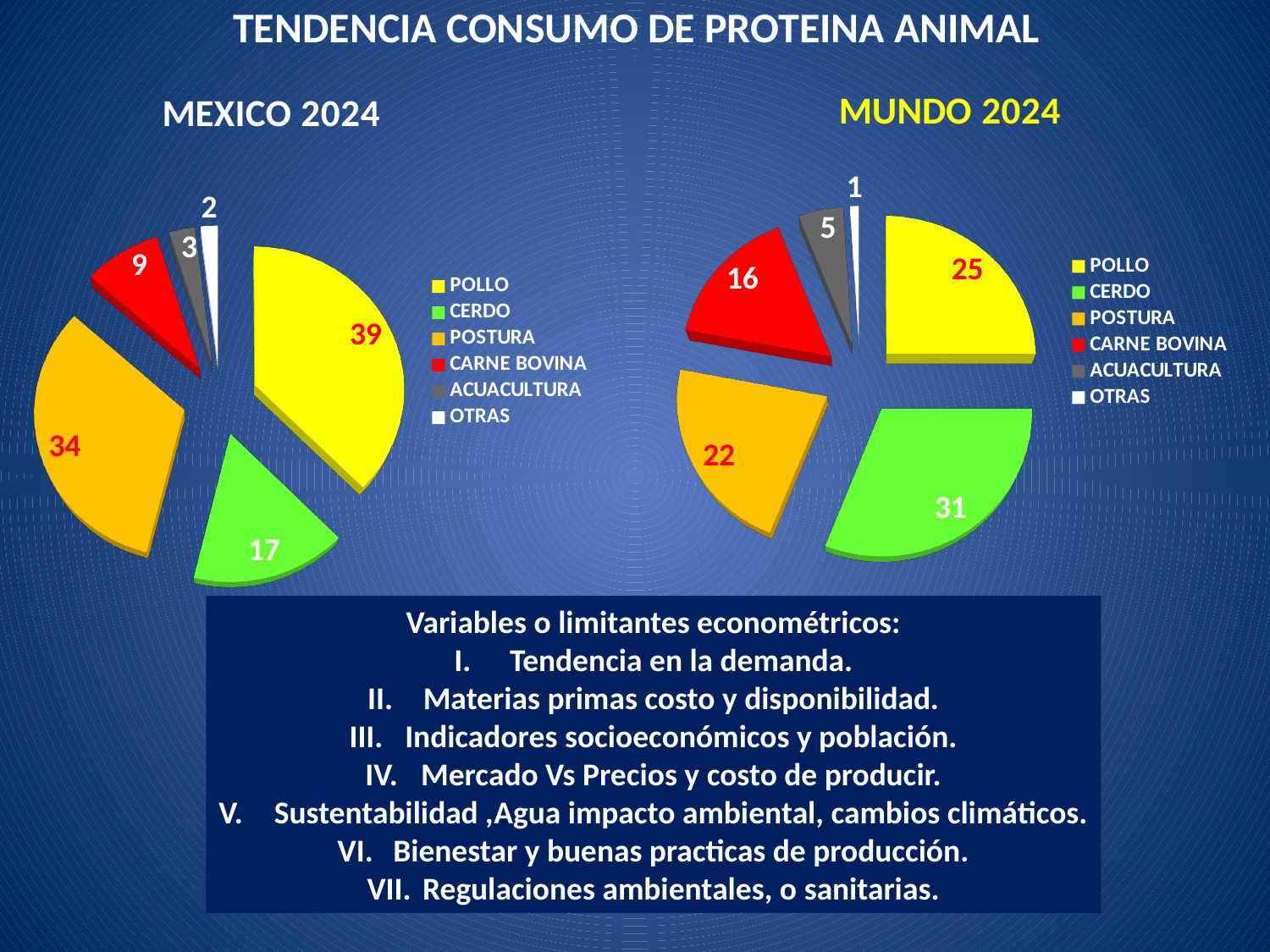
In the MUNDO 2024 chart, what is the value for CARNE BOVINA? 16 In the MEXICO 2024 chart, what is the value for POLLO? 39 In the MUNDO 2024 chart, which category has the smallest slice? OTRAS What kind of chart is the MUNDO 2024 chart? Pie chart In the MUNDO 2024 chart, what is the value for CERDO? 31 In the MEXICO 2024 chart, what is the value for POSTURA? 34 In the MEXICO 2024 chart, what is the difference between the values for POLLO and CERDO? 22 In the MUNDO 2024 chart, which category has the largest slice? CERDO In the MUNDO 2024 chart, what share of the total does POLLO represent? 25% In the MEXICO 2024 chart, which category has the largest slice? POLLO How many categories does the MEXICO 2024 chart show? 6 In the MUNDO 2024 chart, which is larger, POSTURA or CARNE BOVINA? POSTURA